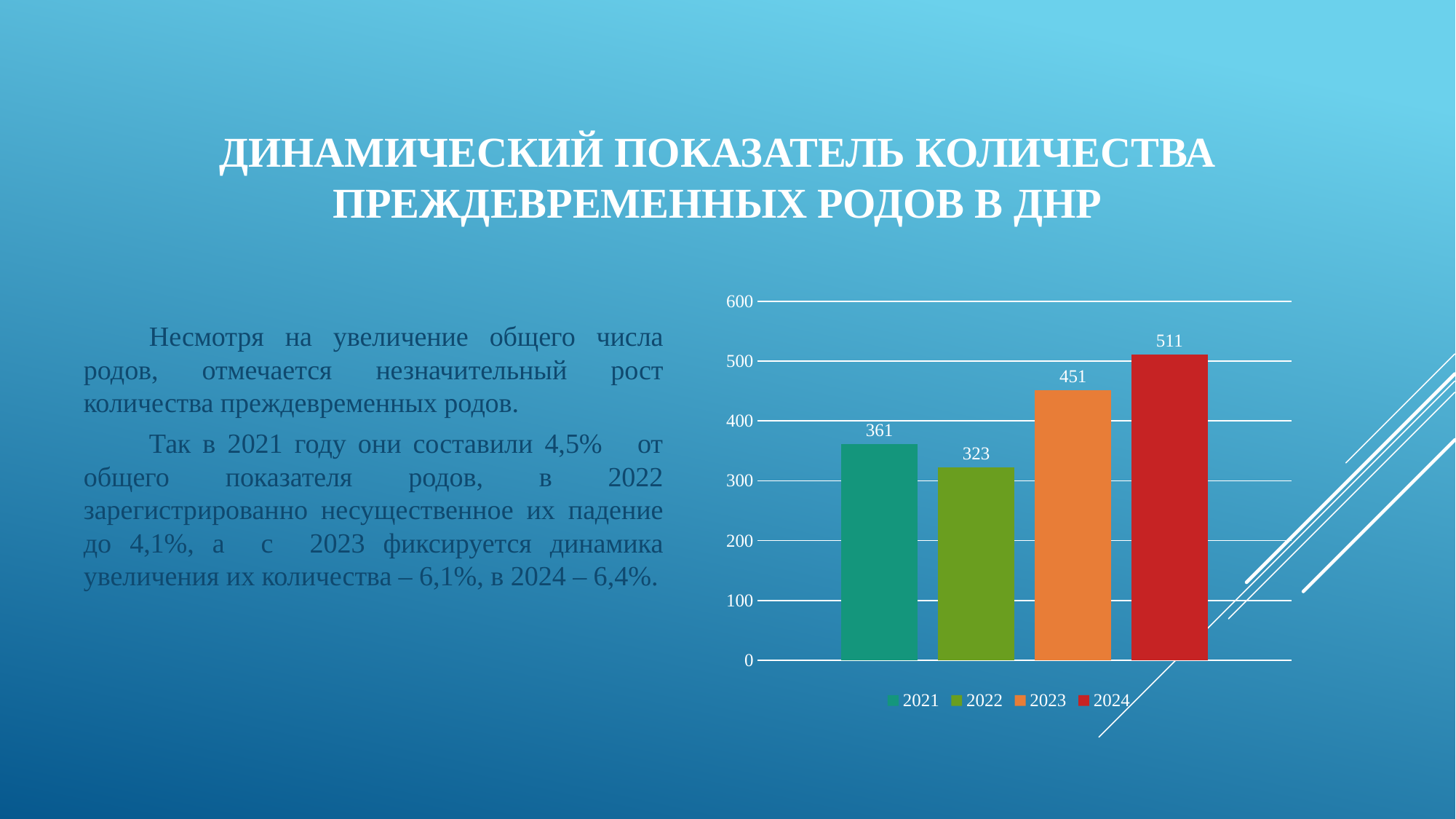
What is the difference between the values for 2024 and 2021? 150 What is the difference between the values for 2023 and 2022? 128 How many bars are shown in the chart? 4 What kind of chart is shown on the slide? Bar chart What is the value for 2021 in the chart? 361 Is the value for 2024 greater or less than 500? greater What colour is the bar for 2024 in the chart? Red How many entries does the chart legend list? 4 Which year has the highest value in the chart? 2024 Which year has the lowest value in the chart? 2022 Which is larger, the value for 2022 or the value for 2023? 2023 What is the value for 2023 in the chart? 451